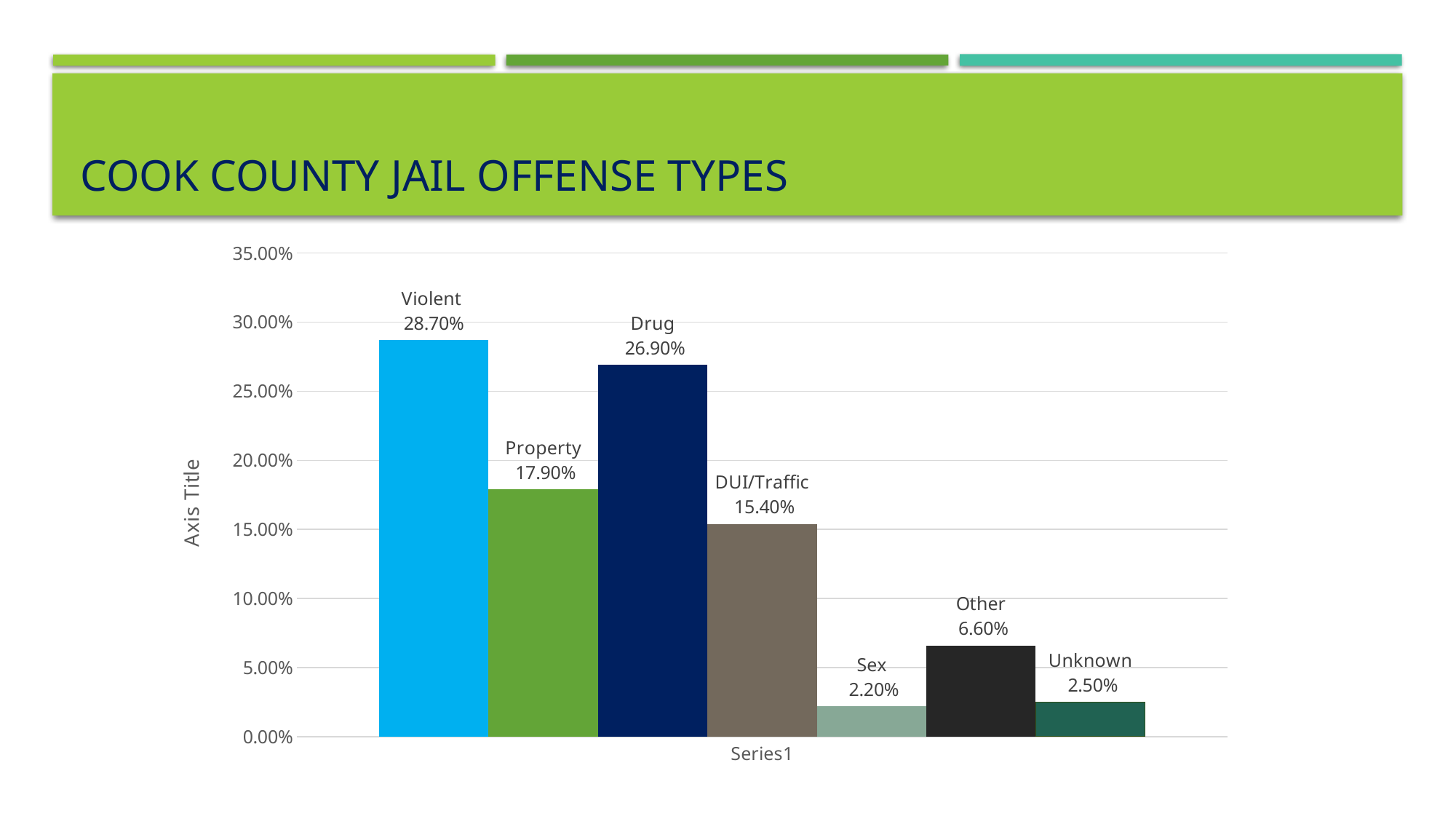
What is the title of the slide? COOK COUNTY JAIL OFFENSE TYPES How many offense types are plotted in the chart? 7 What is the value for Violent? 28.70% Which offense type has the lowest value? Sex What kind of chart is shown on the slide? bar chart What is the difference between the values for Property and DUI/Traffic? 2.50% Is the value for Property greater or less than 20.00%? less What is the value for DUI/Traffic? 15.40% Which is larger, the value for Other or the value for Unknown? Other Which offense type has the highest value? Violent What is the difference between the values for Violent and Drug? 1.80% What is the value for Unknown? 2.50%